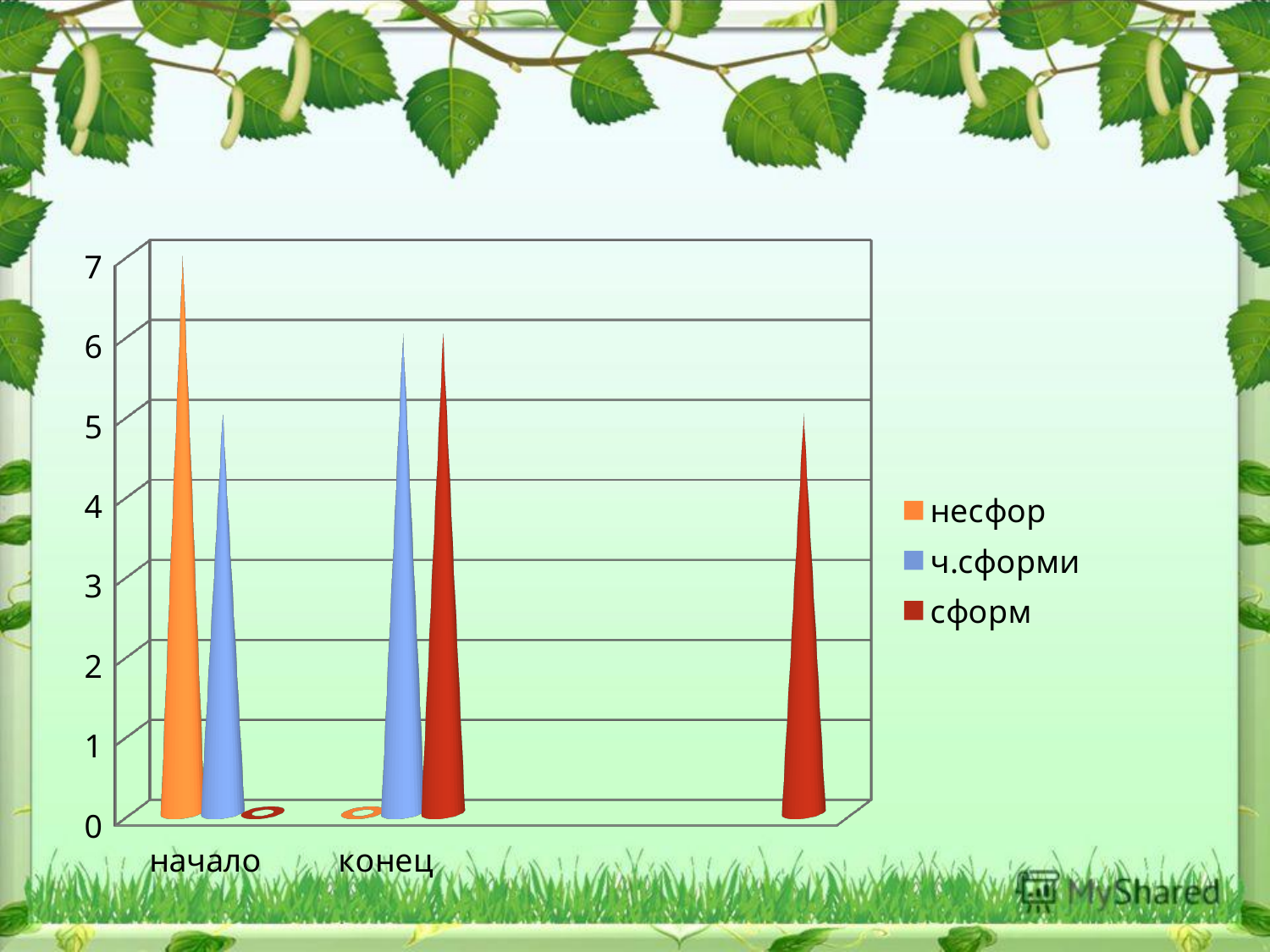
Is the value for несфор in the начало category greater or less than 6? greater Which series has the lowest value in the конец category? несфор What colour represents the сформ series in the legend? red Which series has the highest value in the начало category? несфор What kind of chart is shown on the slide? bar chart Which is larger: несфор in начало or ч.сформи in конец? несфор in начало What is the value for несфор in the начало category? 7 How many series does the legend list? 3 What is the value for ч.сформи in the конец category? 6 What is the value for ч.сформи in the начало category? 5 What is the value for сформ in the конец category? 6 Is the value for ч.сформи in the начало category greater or less than 6? less